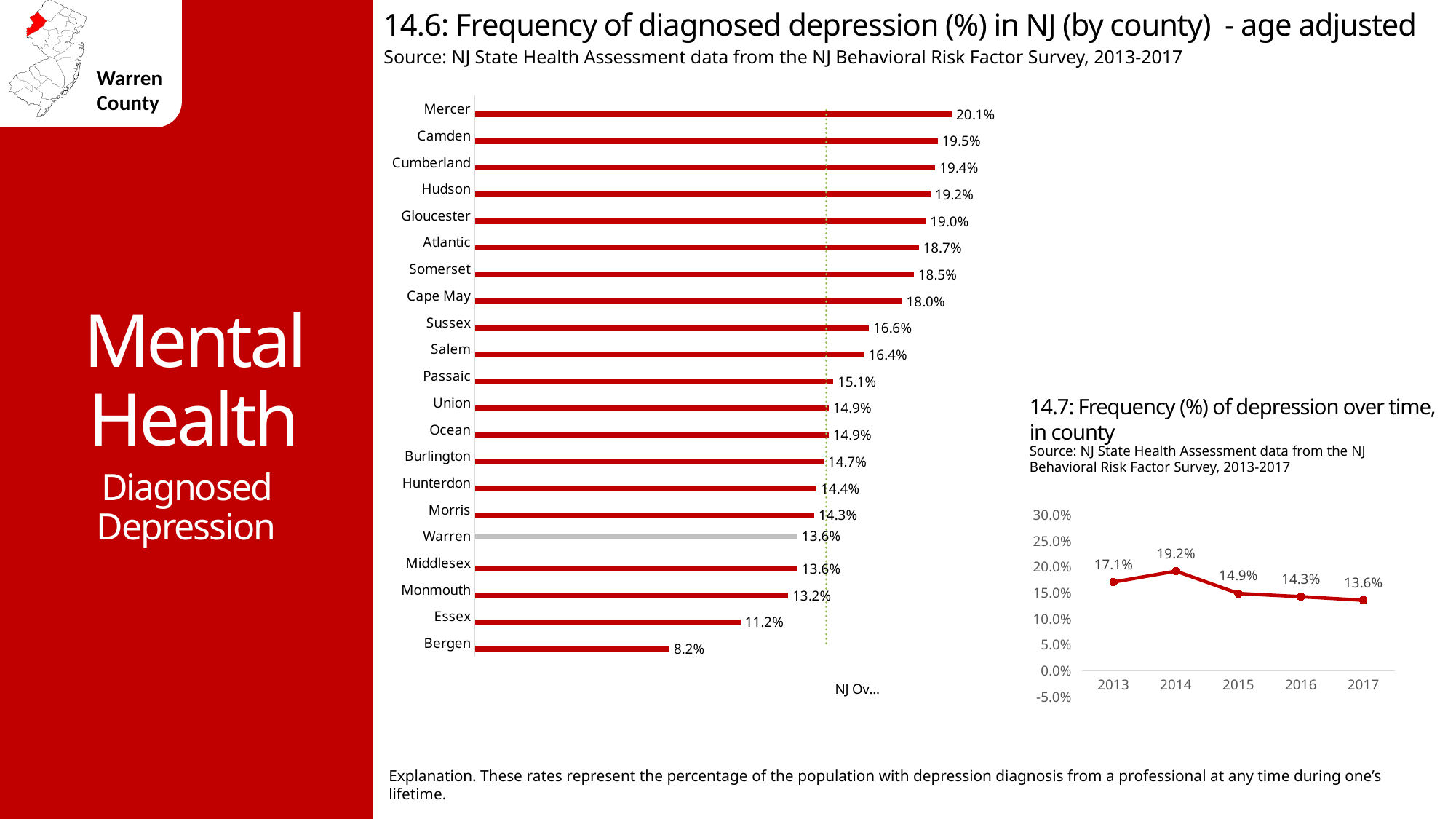
In the chart 14.7 (frequency of depression over time, in county), which year has the lowest value? 2017 In the chart 14.6 (frequency of diagnosed depression by county), what is the value for Warren? 13.6% What kind of chart is chart 14.6 (frequency of diagnosed depression by county)? Bar chart In the chart 14.6 (frequency of diagnosed depression by county), what is the difference between Mercer and Bergen? 11.9% In the chart 14.7 (frequency of depression over time, in county), do the values rise or fall from 2014 to 2017? Fall In the chart 14.6 (frequency of diagnosed depression by county), which is larger, the value for Sussex or the value for Salem? Sussex In the chart 14.6 (frequency of diagnosed depression by county), how many counties are plotted? 21 In the chart 14.6 (frequency of diagnosed depression by county), which county has the lowest value? Bergen In the chart 14.6 (frequency of diagnosed depression by county), what is the value for Essex? 11.2% In the chart 14.6 (frequency of diagnosed depression by county), which county has the highest value? Mercer In the chart 14.7 (frequency of depression over time, in county), what is the value for 2014? 19.2% In the chart 14.7 (frequency of depression over time, in county), what is the difference between 2014 and 2017? 5.6%